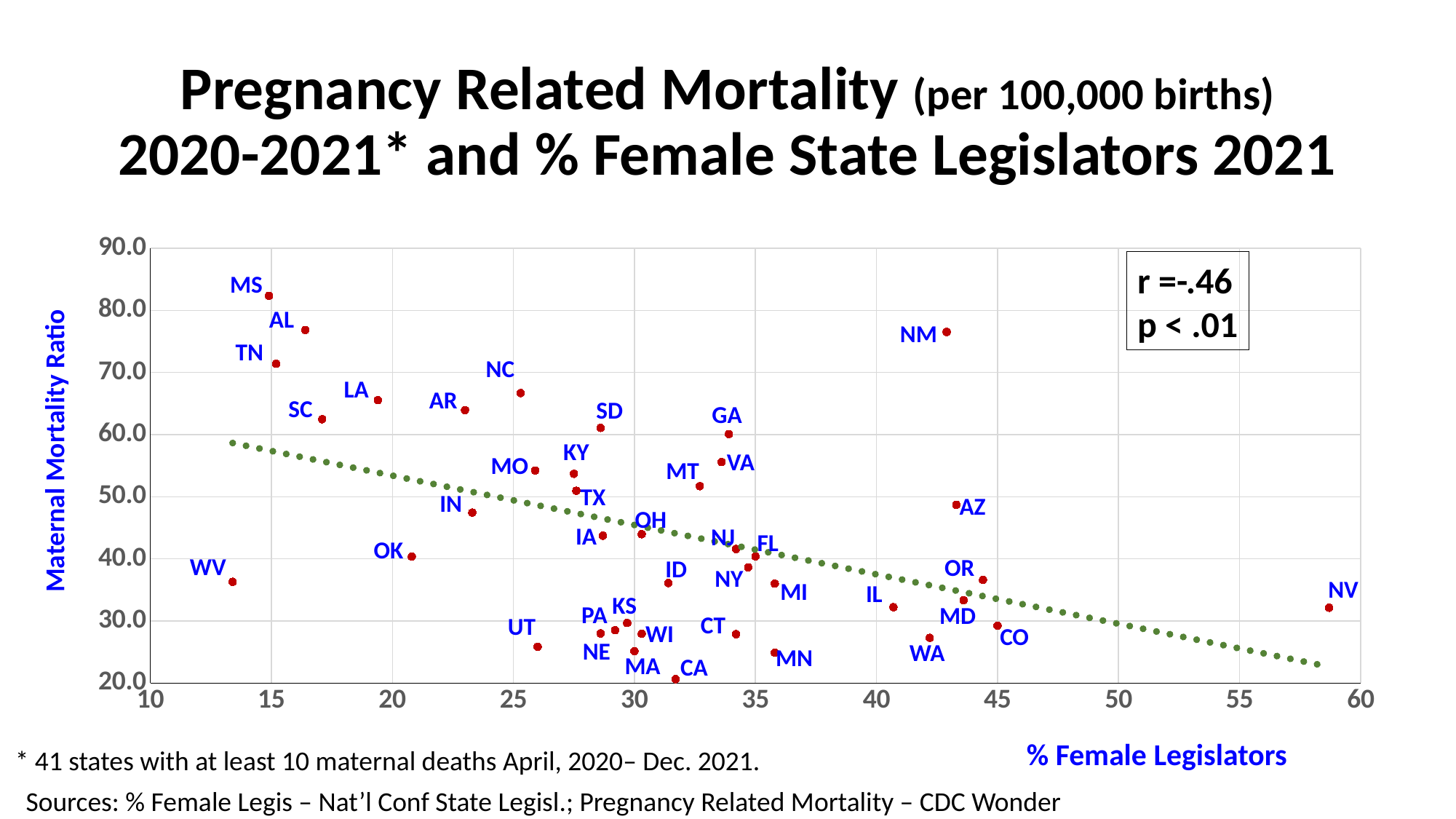
Is the maternal mortality ratio for OK greater or less than 50.0? less What kind of chart is shown on the slide? scatter plot Does the dotted trend line rise or fall as the percentage of female legislators increases? falls Which state has the highest maternal mortality ratio on the chart? MS Which state has the lowest percentage of female legislators on the chart? WV Which state has the lowest maternal mortality ratio on the chart? CA Which state has the highest percentage of female legislators on the chart? NV What correlation coefficient is shown in the box on the chart? r = -.46 Is the maternal mortality ratio for NM greater or less than 70.0? greater Which state has a higher maternal mortality ratio, GA or MN? GA How many states are plotted on the chart, according to the footnote? 41 Is the percentage of female legislators for AZ greater or less than 40? greater